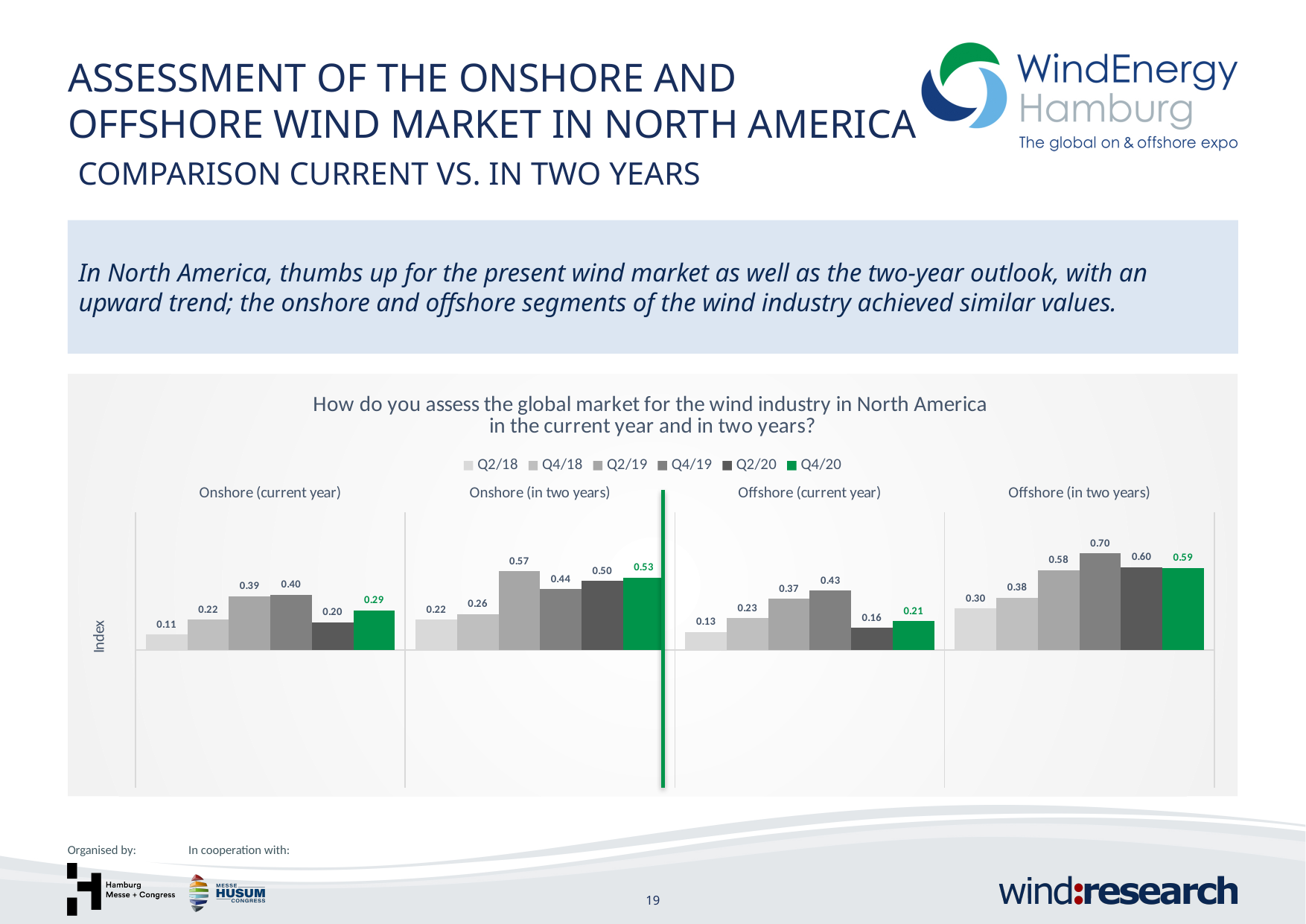
How many series does the legend list? 6 What kind of chart is shown on the slide? Bar chart Which quarter has the lowest value in the Onshore (current year) group? Q2/18 What is the Q2/20 value for Offshore (current year)? 0.16 How many category groups are shown on the x axis? 4 Which is larger: the Q4/20 value for Onshore (in two years) or the Q4/20 value for Onshore (current year)? Onshore (in two years) Which quarter has the highest value in the Offshore (in two years) group? Q4/19 Which series is shown in green in the chart? Q4/20 What is the difference between the Q4/20 values for Offshore (in two years) and Offshore (current year)? 0.38 What is the Q4/20 value for Onshore (current year)? 0.29 What is the Q2/19 value for Onshore (in two years)? 0.57 What is the Q4/19 value for Offshore (in two years)? 0.70